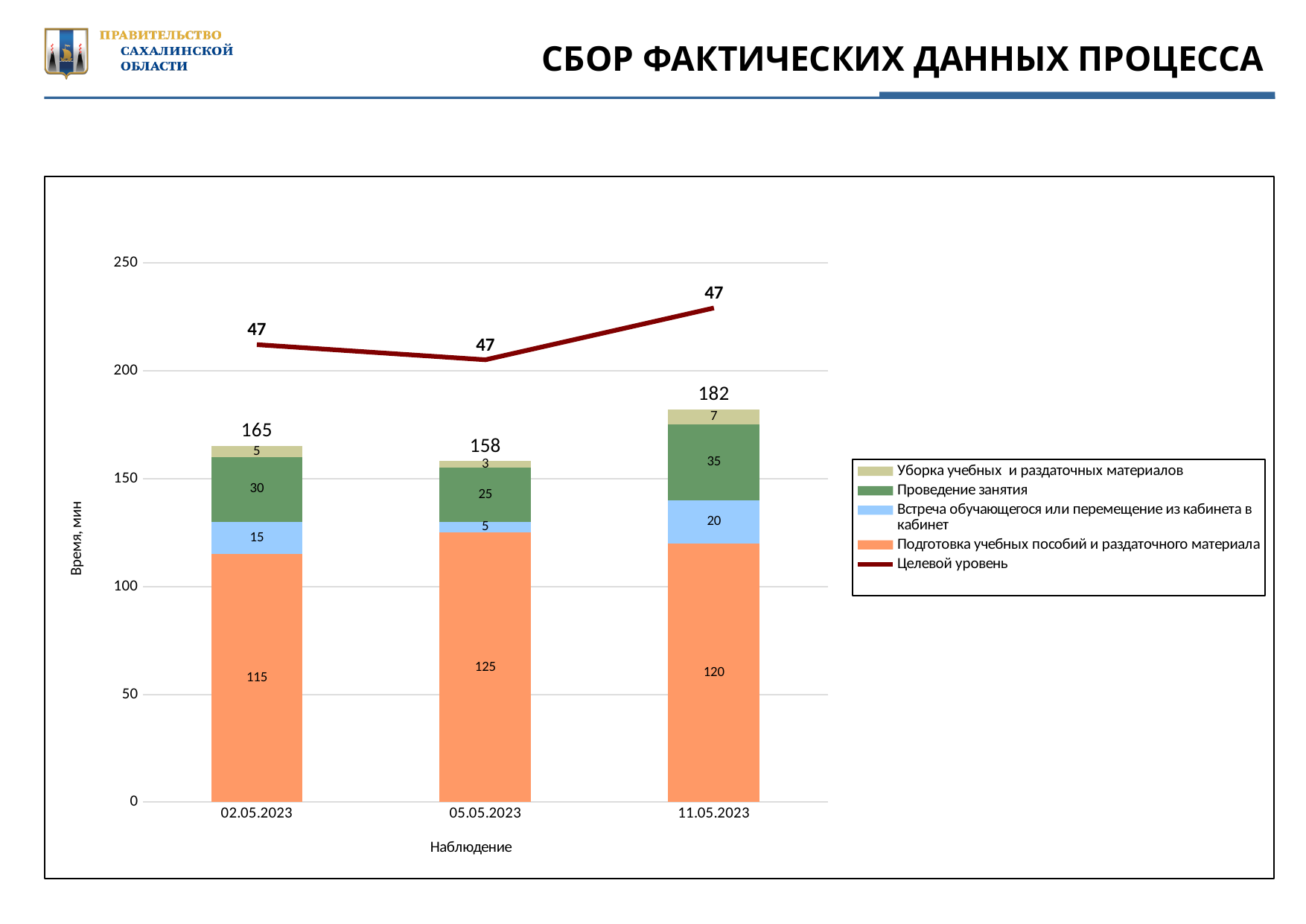
Which is larger: the 'Встреча обучающегося или перемещение из кабинета в кабинет' value for 02.05.2023 or for 11.05.2023? 11.05.2023 What is the value of 'Подготовка учебных пособий и раздаточного материала' for 05.05.2023? 125 How many observation dates are shown on the x axis? 3 Which observation date has the lowest stacked bar total? 05.05.2023 Which observation date has the highest stacked bar total? 11.05.2023 What is the total value of the stacked bar for 02.05.2023? 165 What is the label of the y axis? Время, мин What is the difference between the stacked bar totals for 11.05.2023 and 02.05.2023? 17 What is the value of 'Проведение занятия' for 11.05.2023? 35 How many series does the legend list? 5 What is the value of 'Уборка учебных и раздаточных материалов' for 05.05.2023? 3 What is the value of 'Целевой уровень' for 02.05.2023? 47